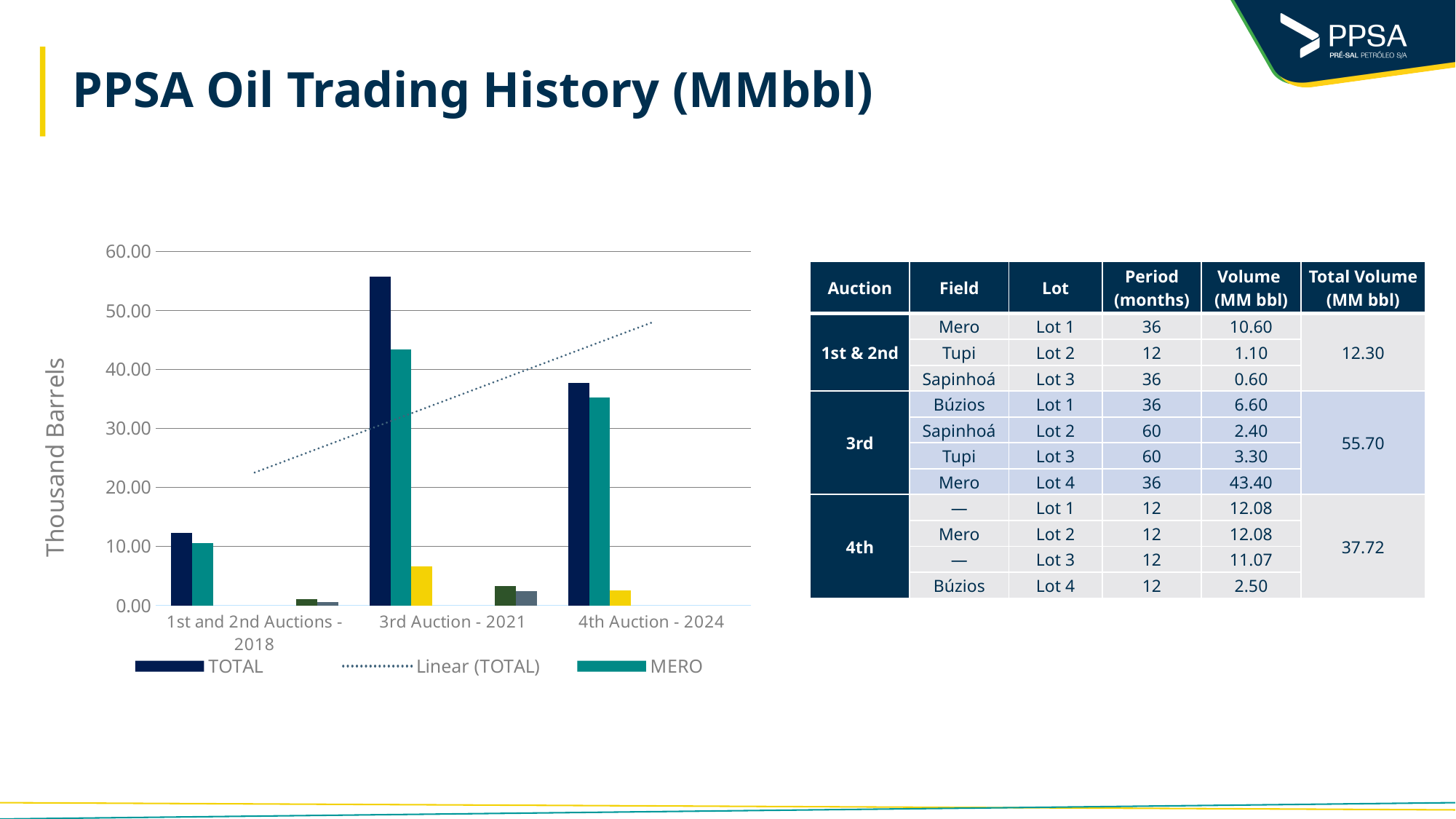
Which auction category has the lowest TOTAL bar? 1st and 2nd Auctions - 2018 What kind of chart is shown on the slide? bar chart Is the TOTAL value for the 4th Auction - 2024 greater or less than 40.00? less Is the MERO bar larger for the 3rd Auction - 2021 or the 4th Auction - 2024? 3rd Auction - 2021 How many series does the chart legend list? 3 Is the MERO value for the 1st and 2nd Auctions - 2018 greater or less than 20.00? less Does the dotted Linear (TOTAL) trend line rise or fall from left to right? rises Which auction category has the highest TOTAL bar? 3rd Auction - 2021 Which legend entry is drawn as a dotted line? Linear (TOTAL) How many auction categories are shown on the x axis of the chart? 3 What is the label on the vertical axis of the chart? Thousand Barrels Is the TOTAL value for the 3rd Auction - 2021 greater or less than 50.00? greater